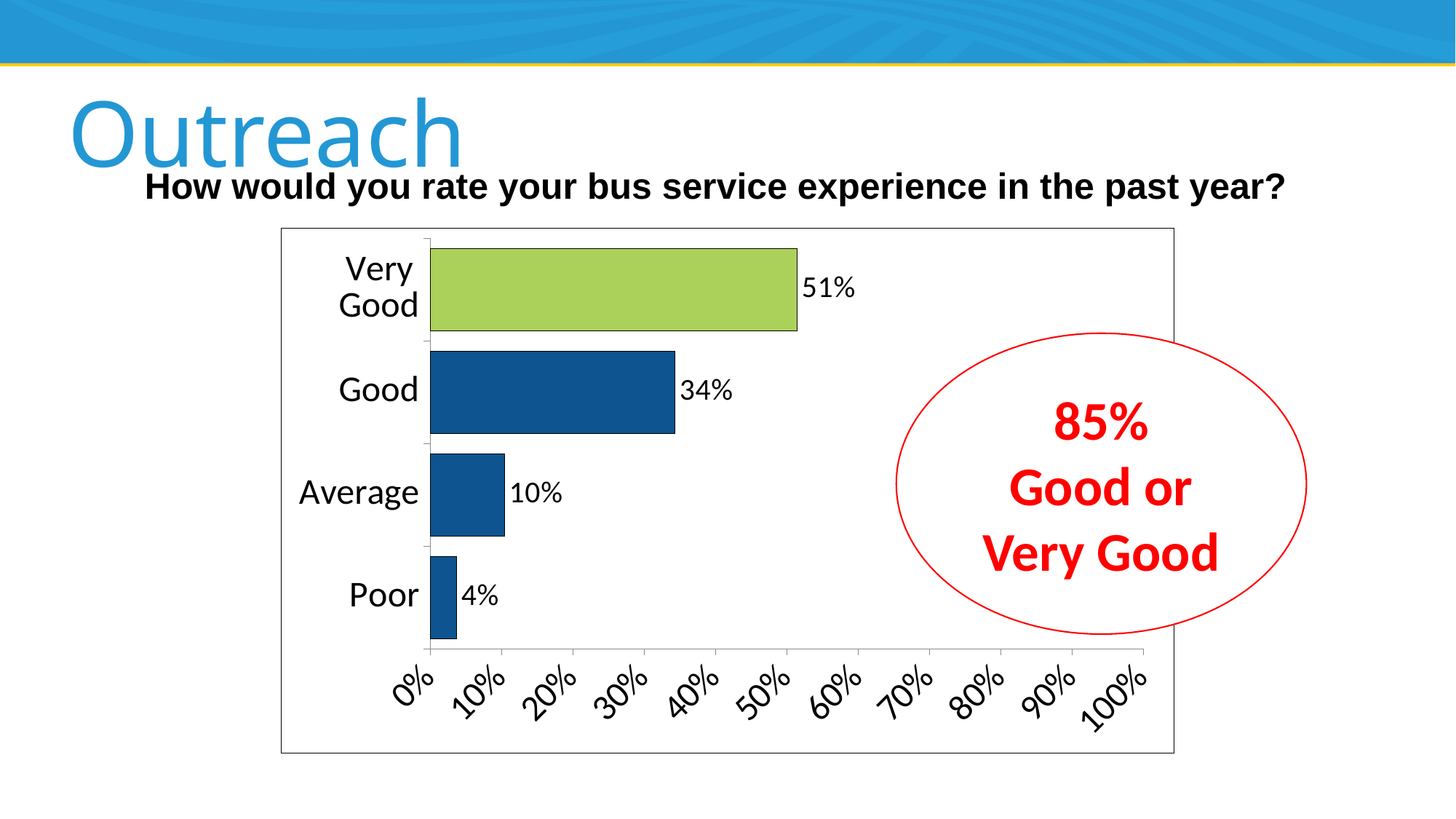
How many rating categories are shown in the chart? 4 What percentage is highlighted in the red circle as Good or Very Good? 85% Which rating category has the lowest percentage? Poor Which rating category has the highest percentage? Very Good What percentage of respondents rated their bus service experience as Poor? 4% What is the difference in percentage points between the Very Good and Good ratings? 17% What percentage of respondents rated their bus service experience as Average? 10% Which is larger, the percentage for Average or the percentage for Poor? Average What kind of chart is shown on the slide? Bar chart What percentage of respondents rated their bus service experience as Very Good? 51% What percentage of respondents rated their bus service experience as Good? 34% Is the value for Good greater or less than 30%? greater